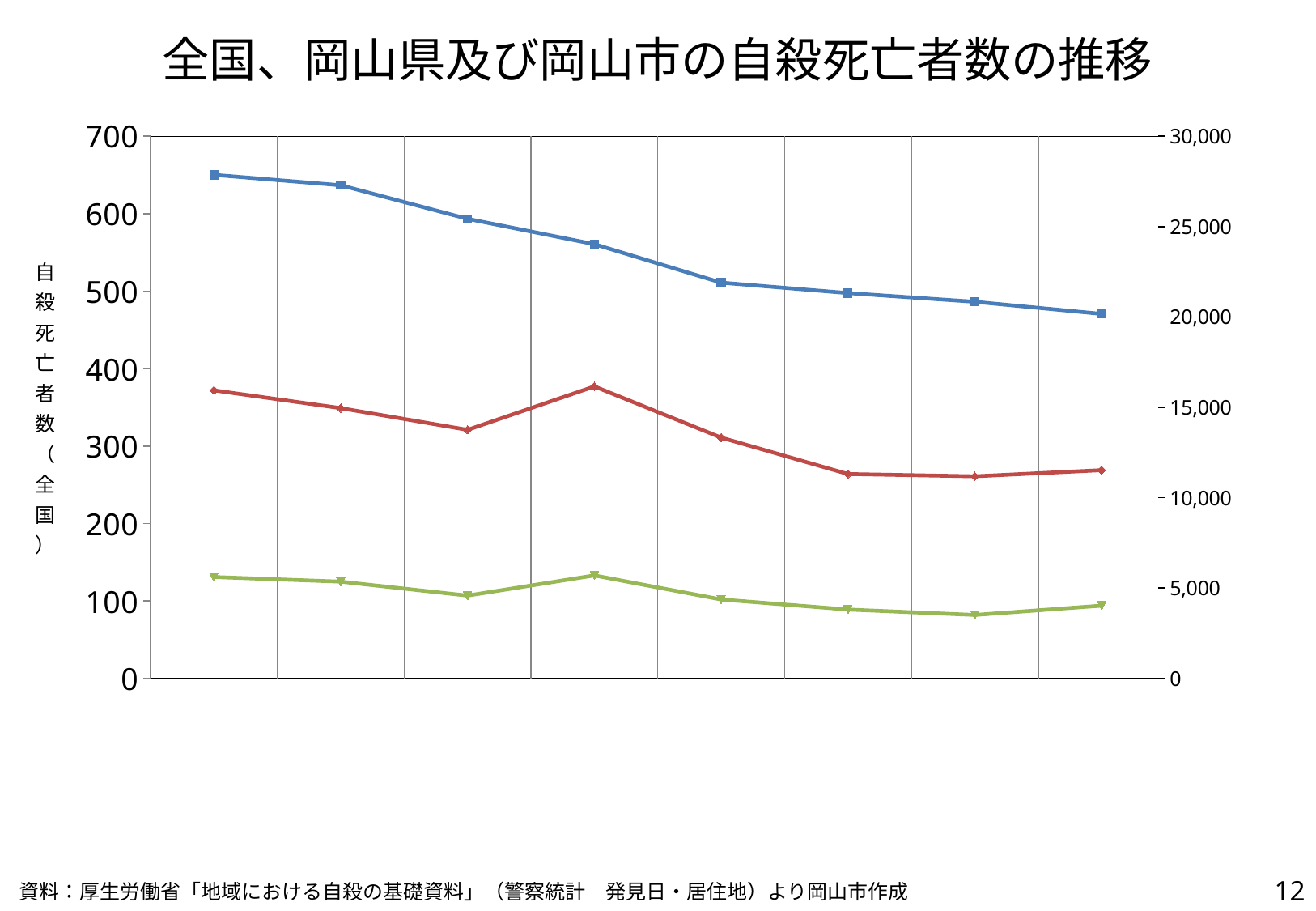
What is the maximum tick value shown on the right-hand axis of the chart? 30,000 What is the title of the chart? 全国、岡山県及び岡山市の自殺死亡者数の推移 What kind of chart is shown on the slide? line chart Which line is plotted lowest on the chart: the blue, red or green line? green On the left axis scale, is the first point of the blue line greater or less than 600? greater On the left axis scale, is the first point of the red line greater or less than 300? greater Does the blue line rise or fall from left to right across the chart? fall How many data points does each line on the chart have? 8 Which line is plotted highest on the chart: the blue, red or green line? blue On the left axis scale, is the highest point of the green line greater or less than 200? less How many lines are plotted on the chart? 3